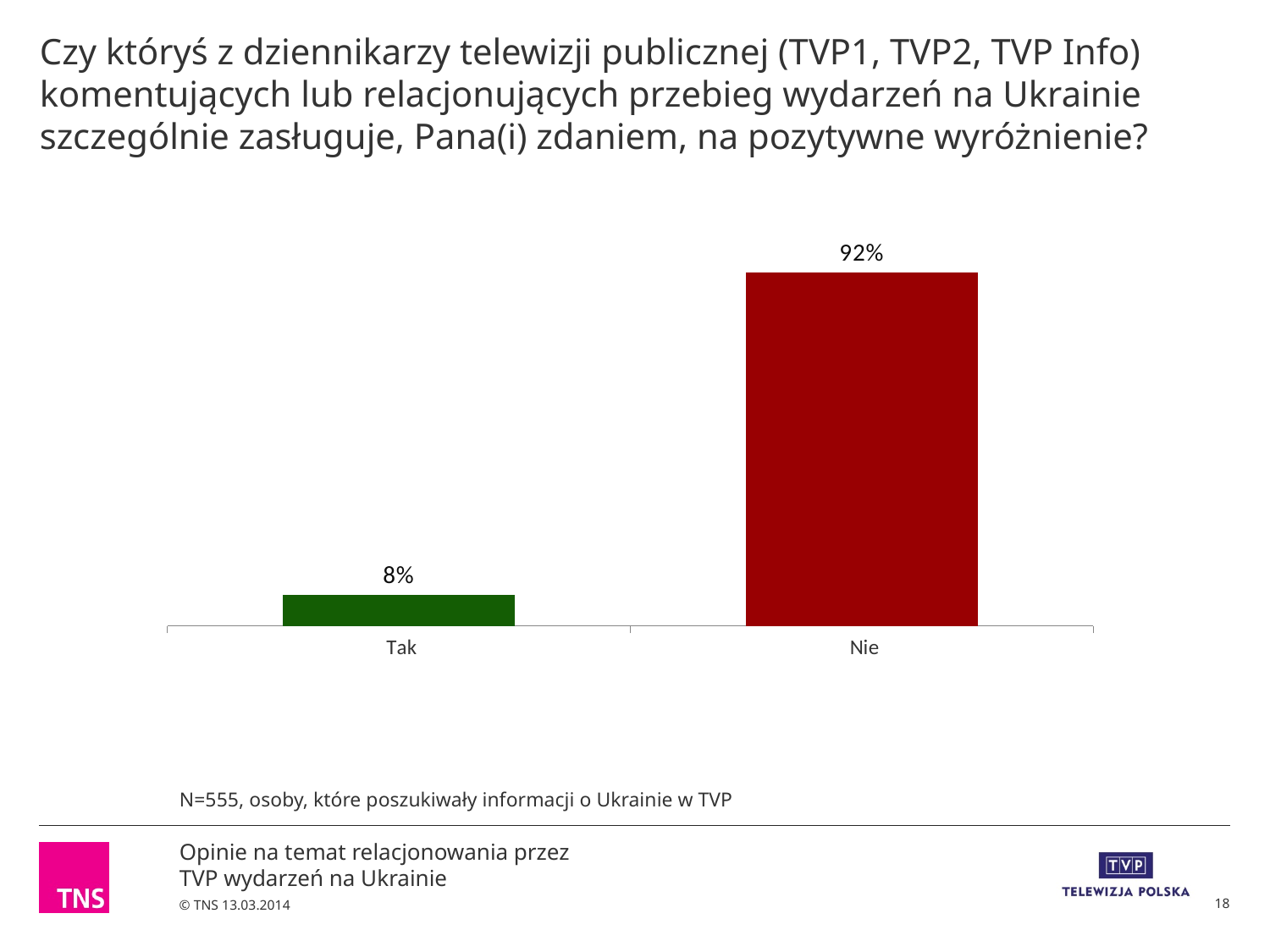
Which category has the highest value? Nie What is the value for "Nie"? 92% What colour is the bar for "Tak"? Green What colour is the bar for "Nie"? Dark red How many categories are shown in the chart? 2 Which is larger, the value for "Tak" or the value for "Nie"? Nie What kind of chart is shown on the slide? Bar chart What is the value for "Tak"? 8% What is the total of the values for "Tak" and "Nie"? 100% Which category has the lowest value? Tak What is the difference between the values for "Nie" and "Tak"? 84%